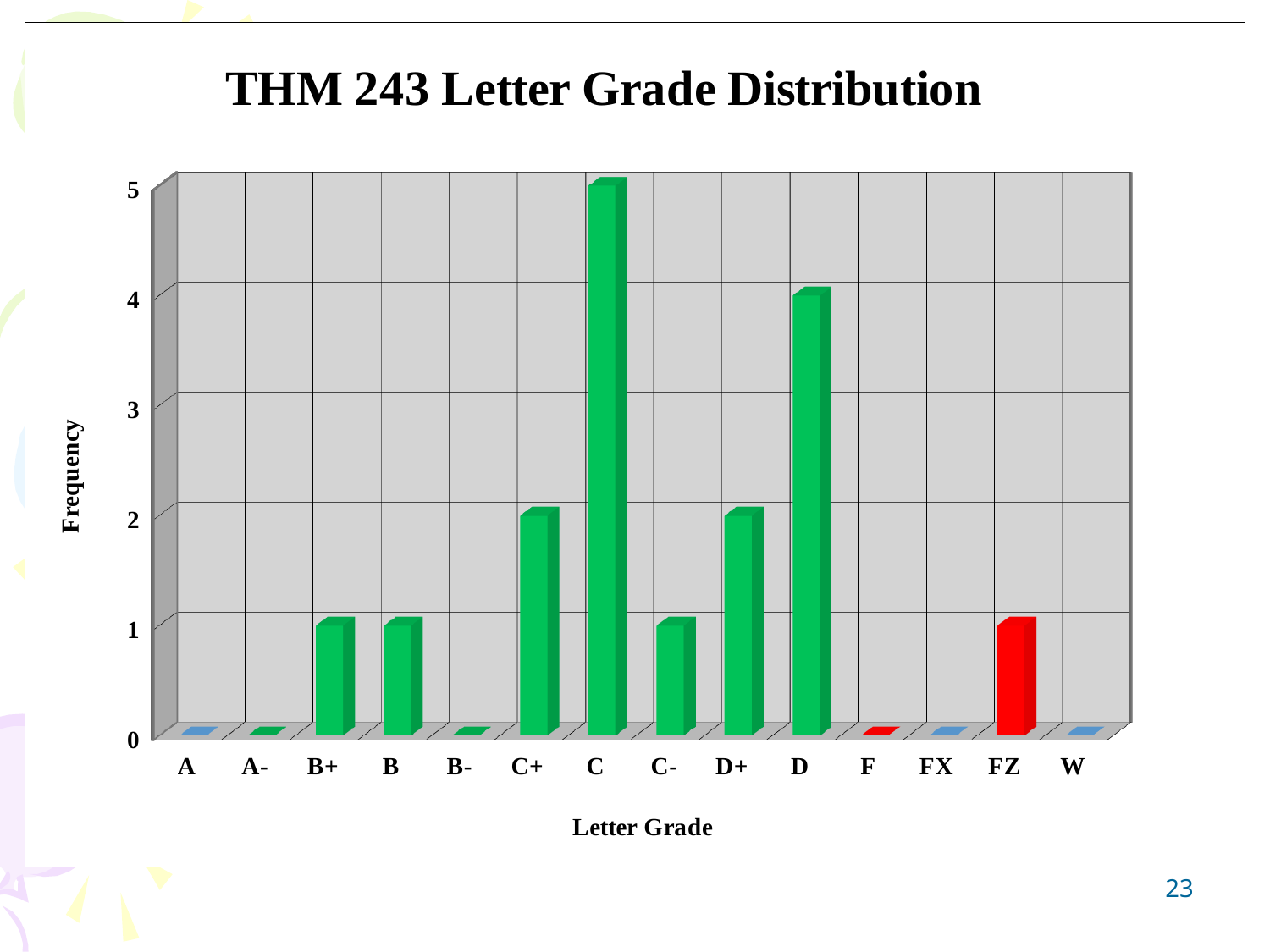
How many letter grade categories are shown on the x axis? 14 Which has a higher frequency, grade D+ or grade C-? D+ What is the frequency for letter grade FZ? 1 Which letter grade has the highest frequency? C What is the difference in frequency between grade C and grade D? 1 What is the frequency for letter grade D? 4 What kind of chart is shown on the slide? Bar chart What is the difference in frequency between grade C+ and grade B+? 1 Is the frequency for grade D greater or less than 3? greater What is the label of the y axis? Frequency What is the title of the chart? THM 243 Letter Grade Distribution What is the frequency for letter grade C? 5